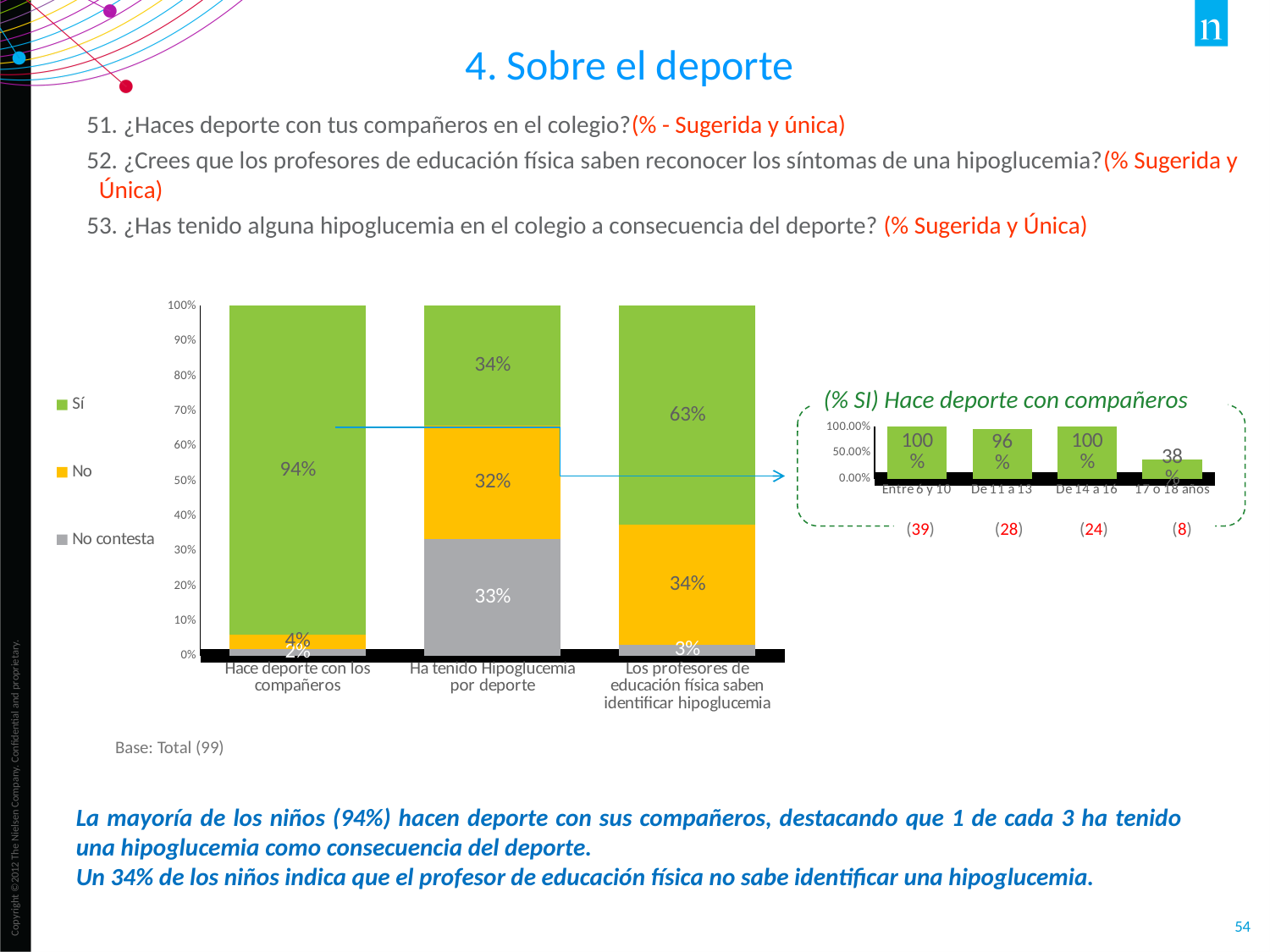
In the small chart titled '(% SI) Hace deporte con compañeros', how many age groups are shown? 4 In the large stacked bar chart, what is the 'Sí' value for 'Los profesores de educación física saben identificar hipoglucemia'? 63% In the large stacked bar chart, what is the 'Sí' value for 'Hace deporte con los compañeros'? 94% In the large stacked bar chart, which category has the highest 'Sí' value? Hace deporte con los compañeros In the large stacked bar chart, how many series does the legend list? 3 In the large stacked bar chart, what is the 'No contesta' value for 'Ha tenido Hipoglucemia por deporte'? 33% What kind of chart is the large chart on the left of the slide? Stacked bar chart In the large stacked bar chart, what is the 'No' value for 'Los profesores de educación física saben identificar hipoglucemia'? 34% In the small chart titled '(% SI) Hace deporte con compañeros', which age group has the lowest value? 17 o 18 años In the large stacked bar chart, what is the difference between the 'Sí' values for 'Hace deporte con los compañeros' and 'Ha tenido Hipoglucemia por deporte'? 60% In the small chart titled '(% SI) Hace deporte con compañeros', what is the value for 'De 11 a 13'? 96% In the large stacked bar chart, which is larger: the 'No' value for 'Hace deporte con los compañeros' or the 'No' value for 'Los profesores de educación física saben identificar hipoglucemia'? Los profesores de educación física saben identificar hipoglucemia